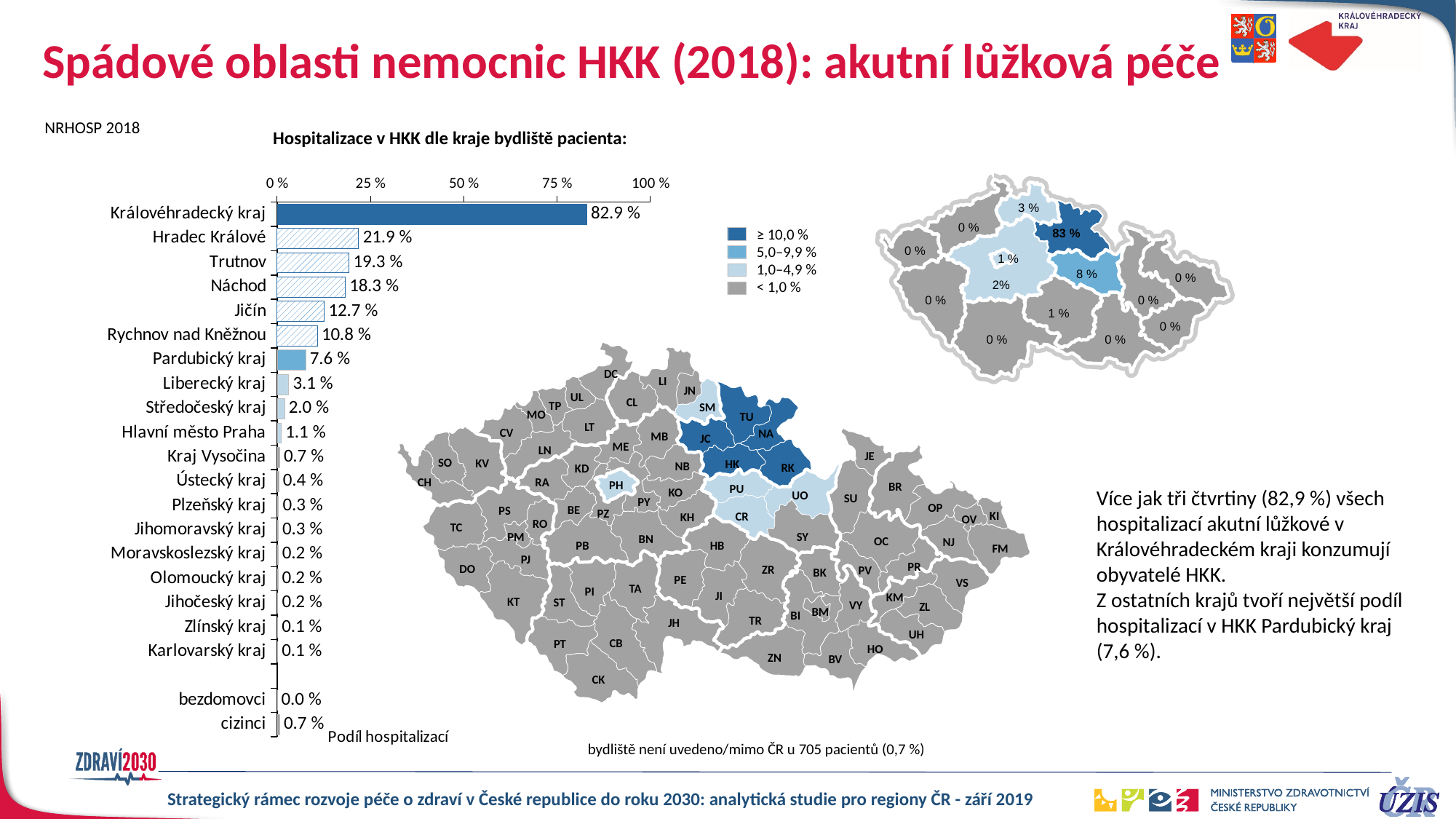
Which is larger, the value for Jičín or the value for Rychnov nad Kněžnou? Jičín What kind of chart is used to show hospitalizations by region of residence? bar chart Which category has the lowest value in the bar chart? bezdomovci What is the value for Trutnov in the bar chart? 19.3 % What is the value for cizinci in the bar chart? 0.7 % How many categories are shown in the bar chart? 21 Is the value for Královéhradecký kraj greater or less than 75 %? greater What is the value for Královéhradecký kraj in the bar chart? 82.9 % Which category has the highest value in the bar chart? Královéhradecký kraj What is the title of the bar chart? Hospitalizace v HKK dle kraje bydliště pacienta: What is the value for Pardubický kraj in the bar chart? 7.6 % What is the difference between the values for Hradec Králové and Náchod? 3.6 %